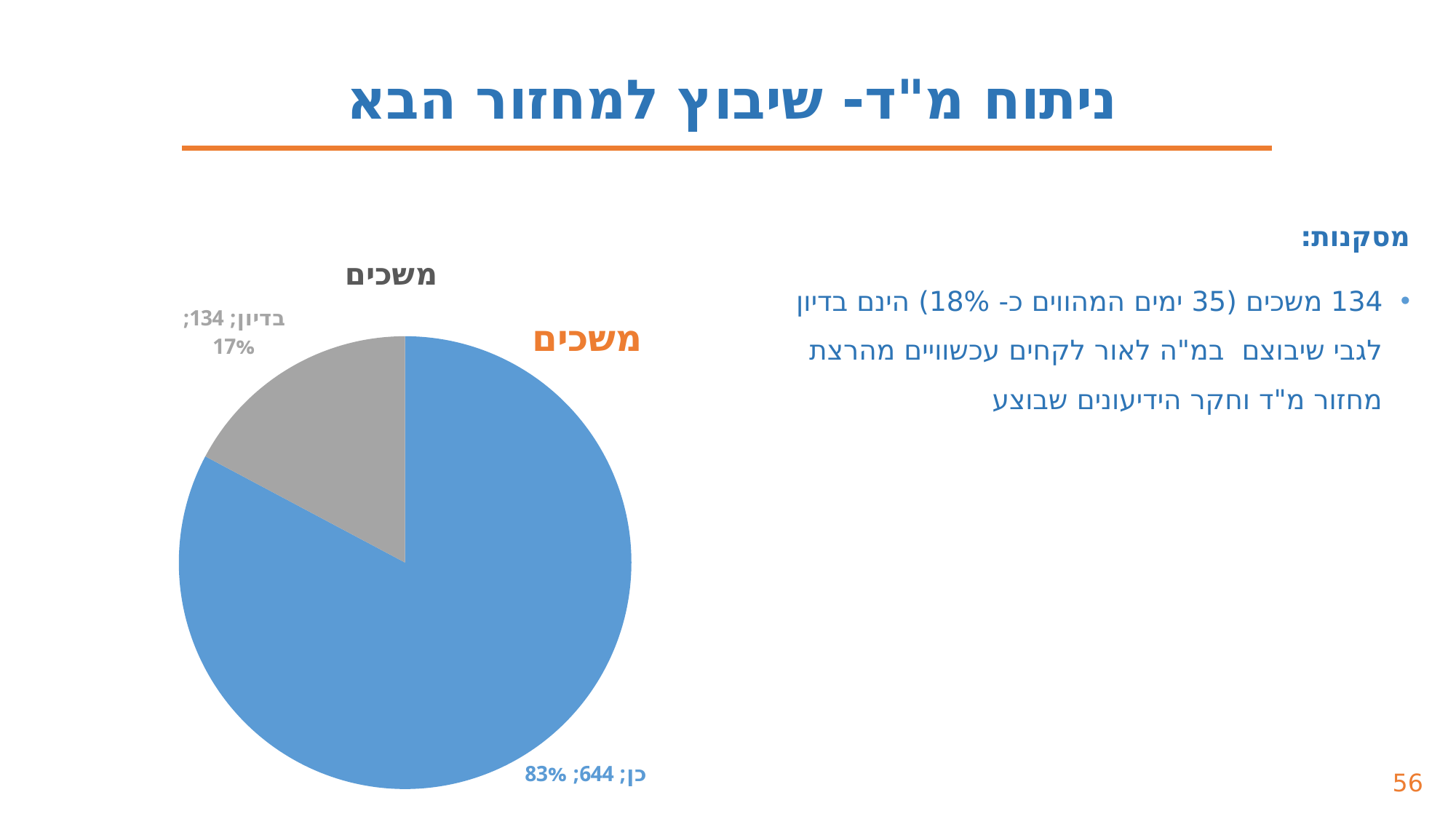
Which slice of the pie chart is the smallest? בדיון What is the value for the slice labelled "בדיון"? 134 What is the value for the slice labelled "כן"? 644 What kind of chart is shown on the slide? pie chart What share of the pie does the "בדיון" slice represent? 17% How many slices does the pie chart have? 2 What is the difference between the values for "כן" and "בדיון"? 510 What share of the pie does the "כן" slice represent? 83% Which slice of the pie chart is the largest? כן What is the title of the pie chart? משכים What colour is the "בדיון" slice in the pie chart? grey What is the total of the two slice values in the pie chart? 778